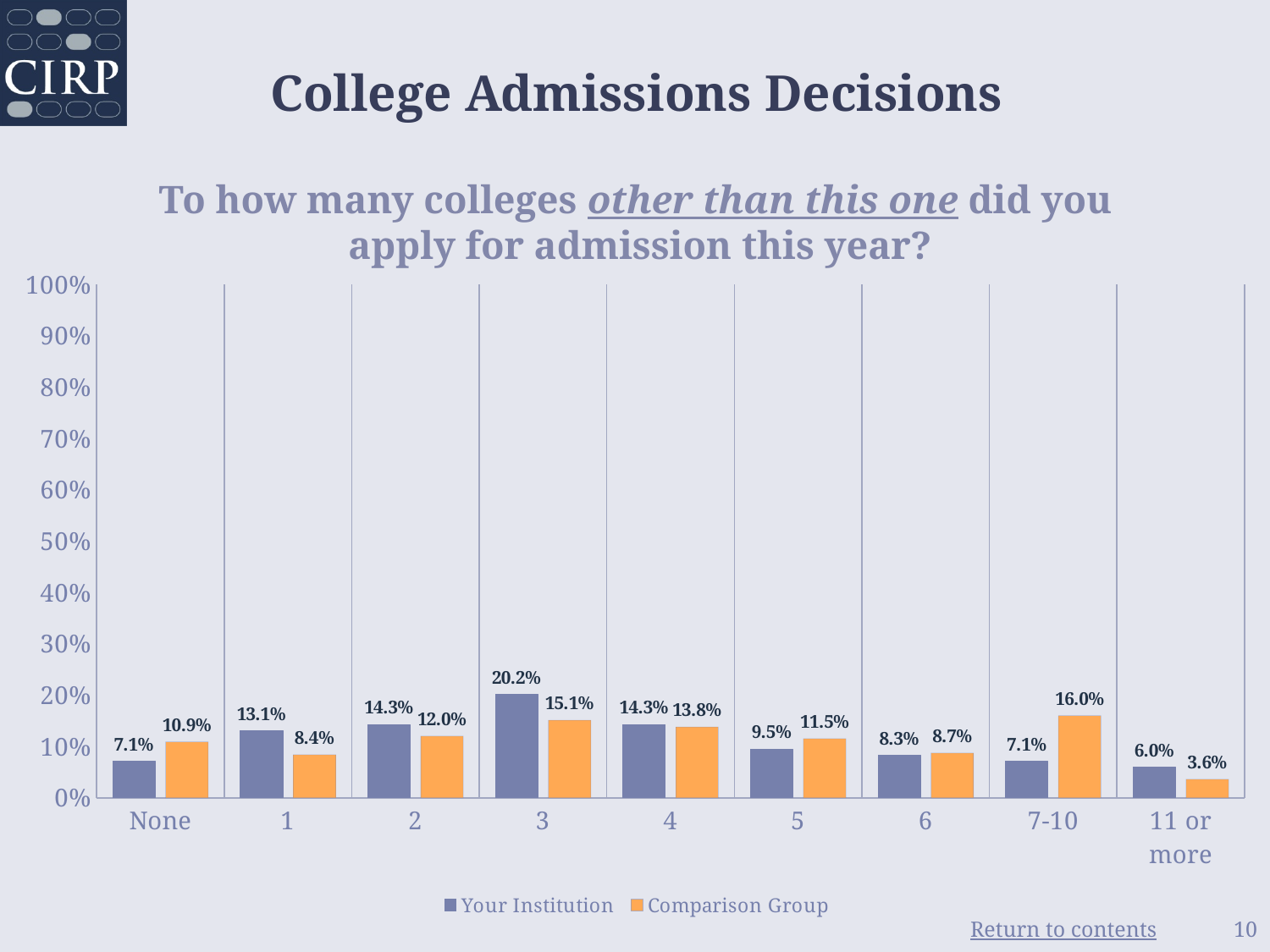
Which category has the lowest value for Comparison Group? 11 or more What is the value for Your Institution in the 'None' category? 7.1% What is the value for Your Institution in the '3' category? 20.2% How many categories are shown on the x axis? 9 Is the value for Your Institution in the '3' category greater or less than 10%? greater What is the difference between Your Institution and Comparison Group in the '3' category? 5.1% Which category has the highest value for Your Institution? 3 What is the value for Comparison Group in the '7-10' category? 16.0% What colour are the Comparison Group bars? orange What kind of chart is shown on the slide? bar chart How many series does the legend list? 2 Which is larger in the '7-10' category: Your Institution or Comparison Group? Comparison Group